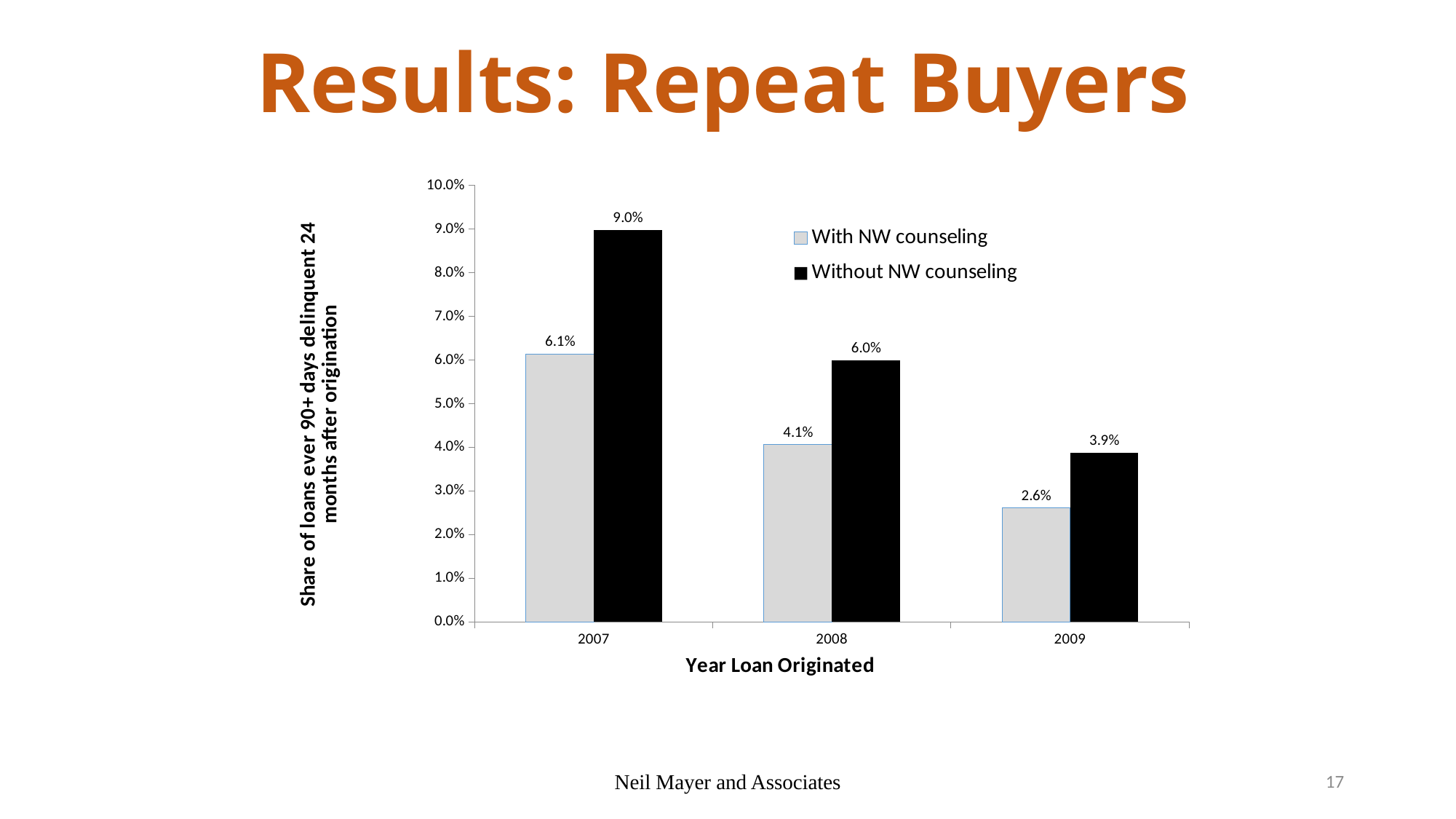
What is the difference between 'Without NW counseling' and 'With NW counseling' in 2007? 2.9% Which is larger in 2009: 'With NW counseling' or 'Without NW counseling'? Without NW counseling How many years are shown on the x axis? 3 Which year has the highest value for 'Without NW counseling'? 2007 Is the value for 'Without NW counseling' in 2009 greater or less than 3.0%? greater What kind of chart is shown on the slide? Bar chart What is the value for 'With NW counseling' in 2009? 2.6% What is the value for 'With NW counseling' in 2007? 6.1% What is the value for 'Without NW counseling' in 2008? 6.0% Do the values for 'With NW counseling' rise or fall from 2007 to 2009? Fall Which year has the lowest value for 'With NW counseling'? 2009 How many series does the legend list? 2